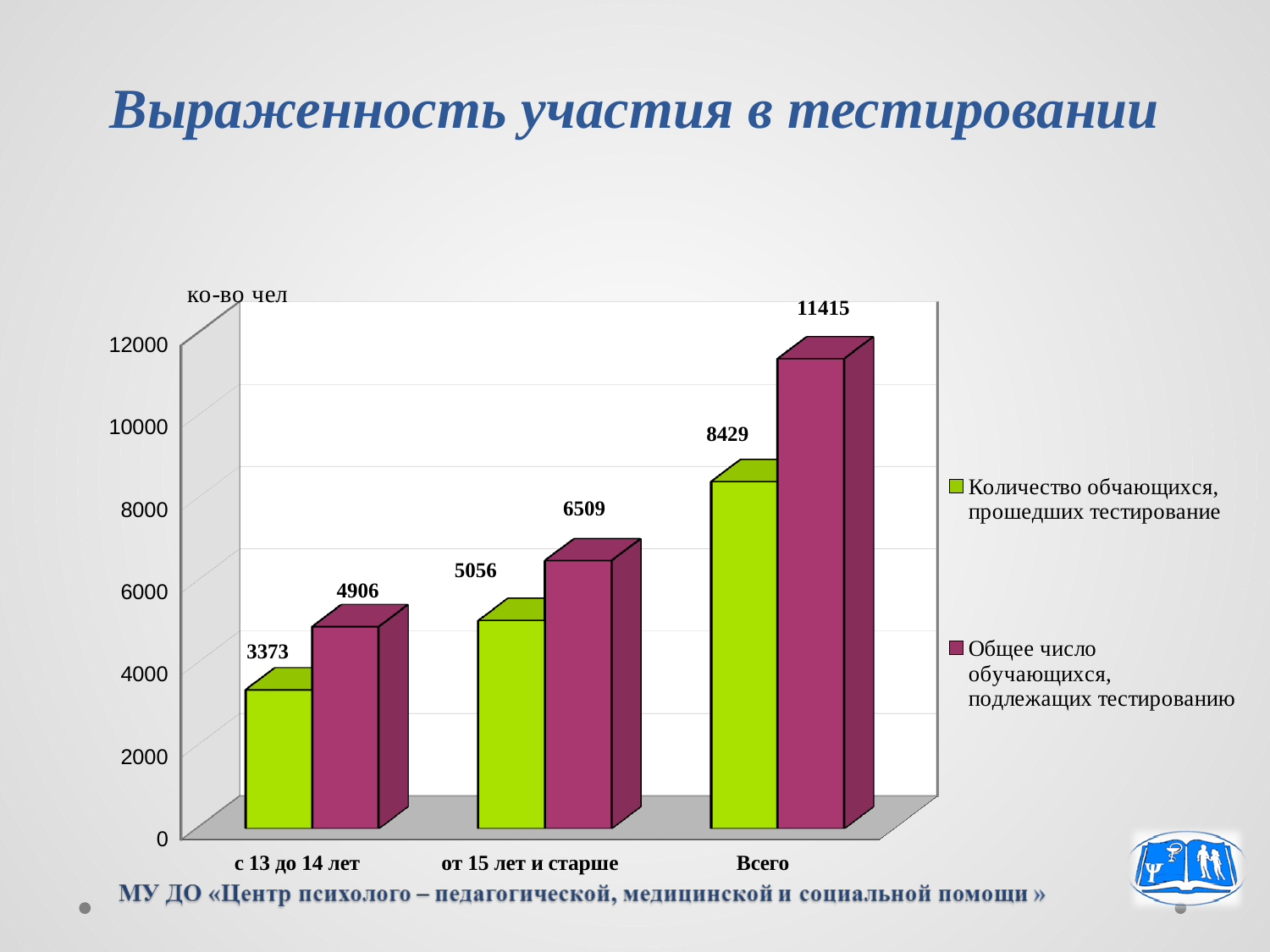
What is the difference between "Общее число обучающихся, подлежащих тестированию" and "Количество обчающихся, прошедших тестирование" for the category "от 15 лет и старше"? 1453 How many series does the legend of the chart list? 2 How many categories are shown on the x axis of the chart? 3 What is the value of "Общее число обучающихся, подлежащих тестированию" for the category "Всего"? 11415 Which category has the lowest value for "Количество обчающихся, прошедших тестирование"? с 13 до 14 лет What is the value of "Общее число обучающихся, подлежащих тестированию" for the category "от 15 лет и старше"? 6509 Which is larger for the category "с 13 до 14 лет": "Количество обчающихся, прошедших тестирование" or "Общее число обучающихся, подлежащих тестированию"? Общее число обучающихся, подлежащих тестированию What kind of chart is shown on the slide? bar chart What is the value of "Количество обчающихся, прошедших тестирование" for the category "с 13 до 14 лет"? 3373 Which category has the highest value for "Общее число обучающихся, подлежащих тестированию"? Всего What is the title of the slide containing the chart? Выраженность участия в тестировании What is the value of "Количество обчающихся, прошедших тестирование" for the category "Всего"? 8429